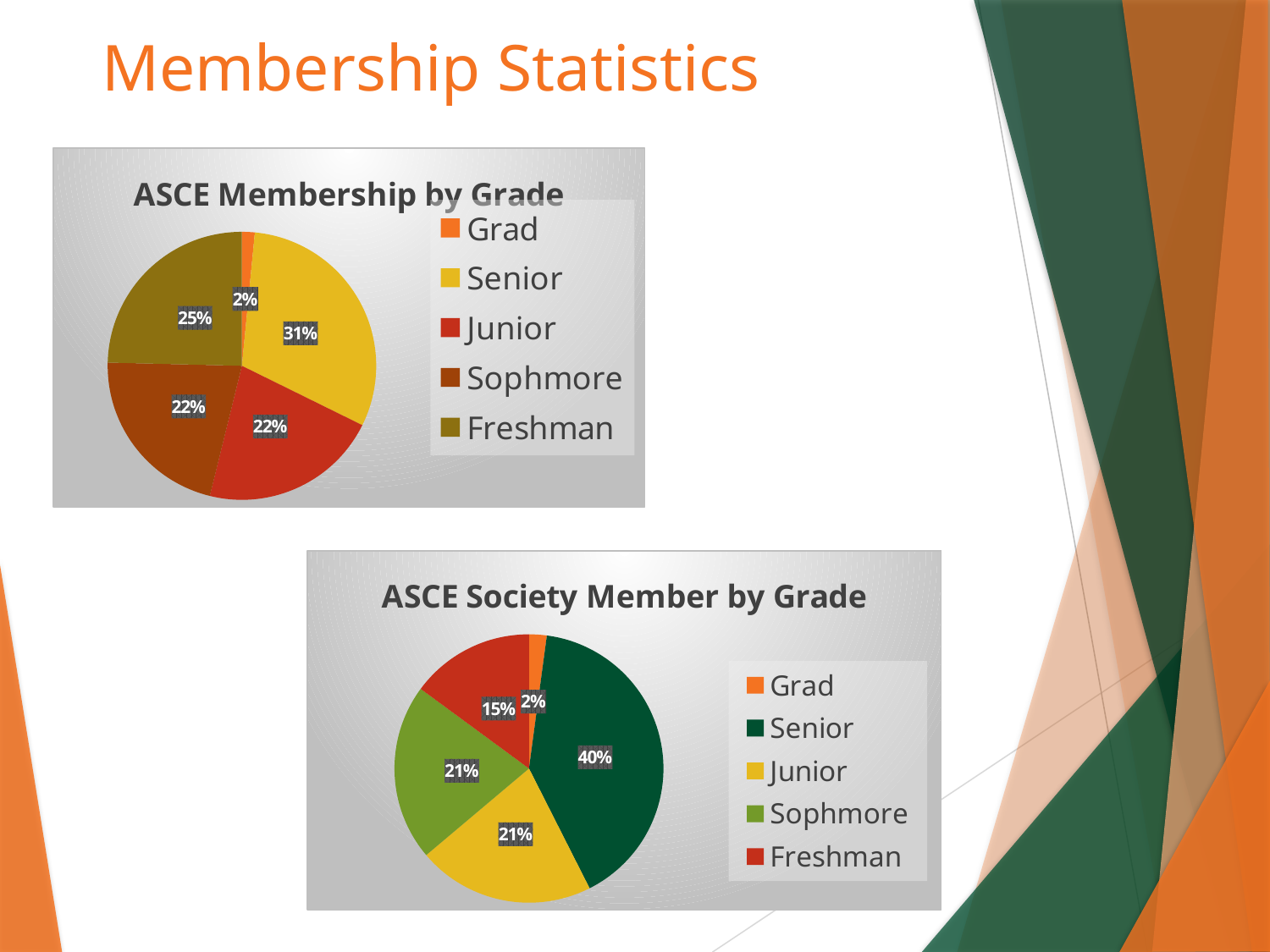
In the 'ASCE Society Member by Grade' chart, which grade has the largest share? Senior In the 'ASCE Membership by Grade' chart, which grade has the smallest share? Grad In the 'ASCE Membership by Grade' chart, what share does Freshman have? 25% In the 'ASCE Membership by Grade' chart, what is the difference between the Senior and Freshman shares? 6% How many categories does the legend of the 'ASCE Society Member by Grade' chart list? 5 In the 'ASCE Society Member by Grade' chart, which is larger, the Junior share or the Freshman share? Junior In the 'ASCE Society Member by Grade' chart, what share does Senior have? 40% In the 'ASCE Society Member by Grade' chart, what is the difference between the Senior and Sophmore shares? 19% In the 'ASCE Society Member by Grade' chart, what share does Freshman have? 15% In the 'ASCE Membership by Grade' chart, what share does Senior have? 31% In the 'ASCE Membership by Grade' chart, which grade has the largest share? Senior What kind of chart is the 'ASCE Membership by Grade' chart? Pie chart